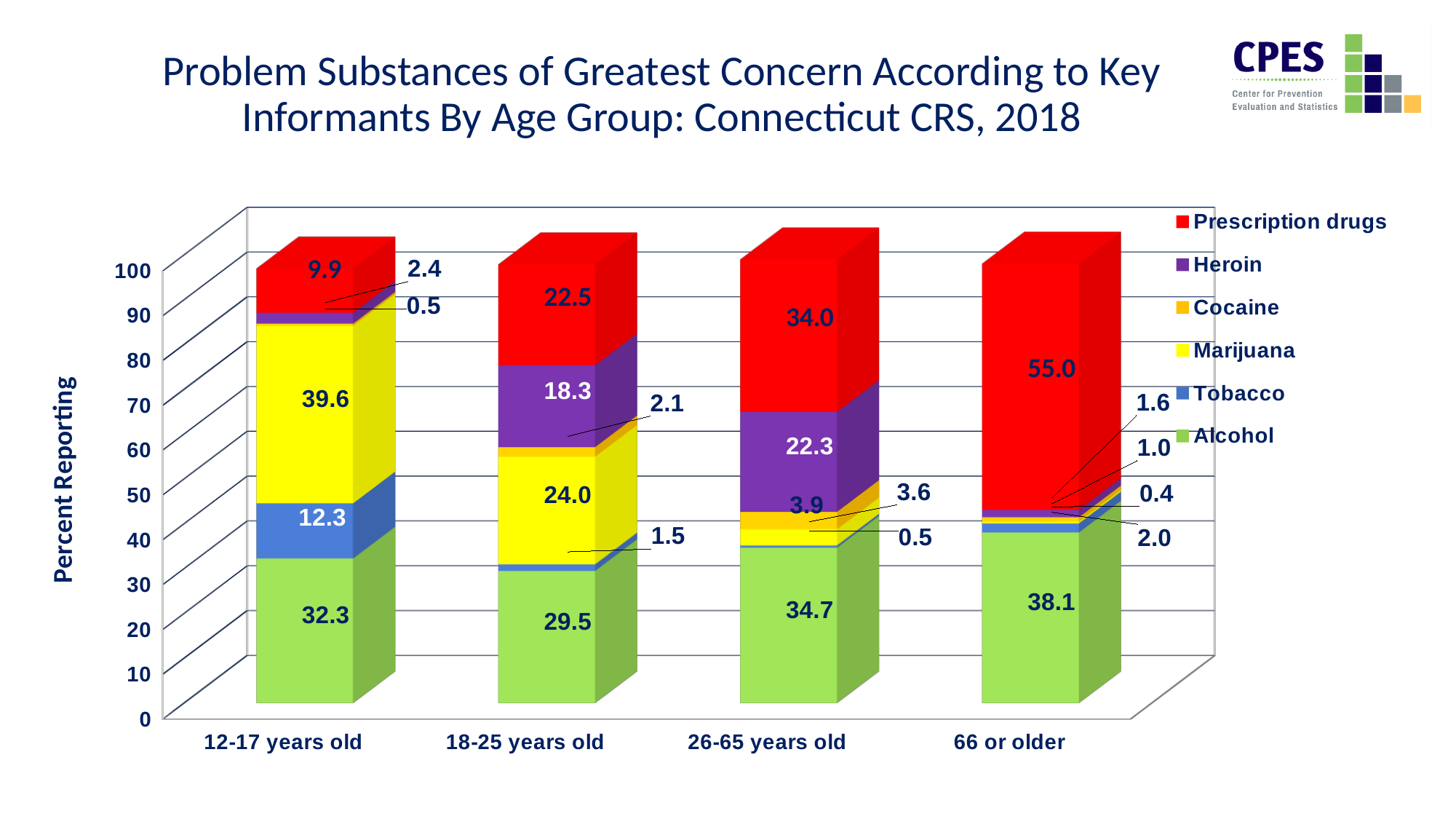
How many series does the legend list? 6 What is the value for Marijuana in the 12-17 years old age group? 39.6 What is the value for Heroin in the 26-65 years old age group? 22.3 How many age groups are shown on the x axis? 4 What is the value for Tobacco in the 12-17 years old age group? 12.3 Which age group has the highest value for Prescription drugs? 66 or older Which age group has the larger Heroin value, 18-25 years old or 26-65 years old? 26-65 years old What is the value for Prescription drugs in the 66 or older age group? 55.0 What is the difference between the Prescription drugs values for 66 or older and 26-65 years old? 21.0 What kind of chart is shown on the slide? Stacked bar chart Do the Prescription drugs values rise or fall as the age groups get older along the x axis? Rise Which age group has the lowest value for Alcohol? 18-25 years old